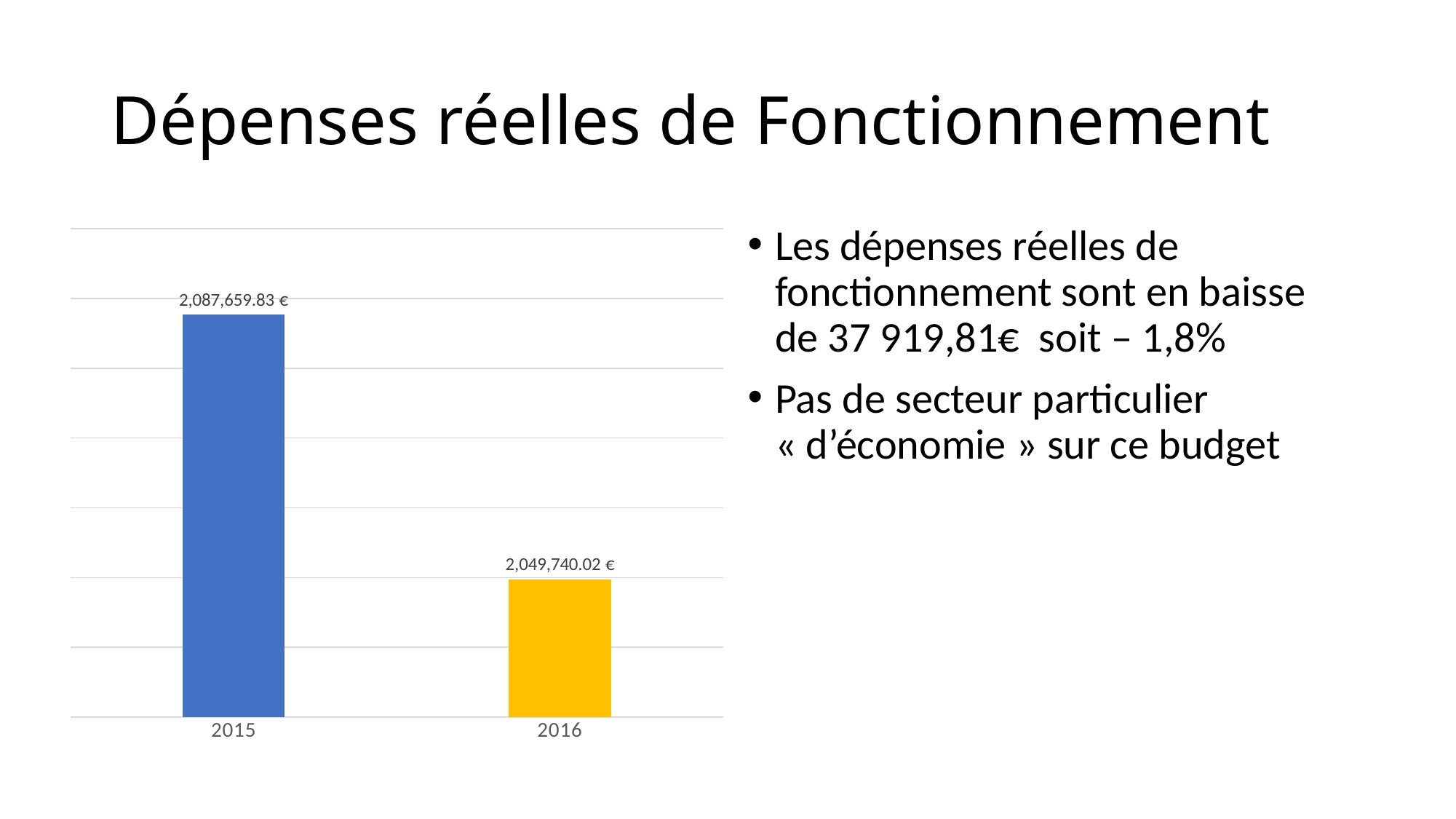
Do the values rise or fall from 2015 to 2016? Fall Which year has the highest value? 2015 What is the value for 2015? 2,087,659.83 € Which year has the lowest value? 2016 Which is larger, the value for 2015 or the value for 2016? 2015 What colour is the bar for 2015? Blue What colour is the bar for 2016? Yellow What kind of chart is shown on the slide? Bar chart What is the value for 2016? 2,049,740.02 € What is the difference between the values for 2015 and 2016? 37,919.81 € How many bars are shown in the chart? 2